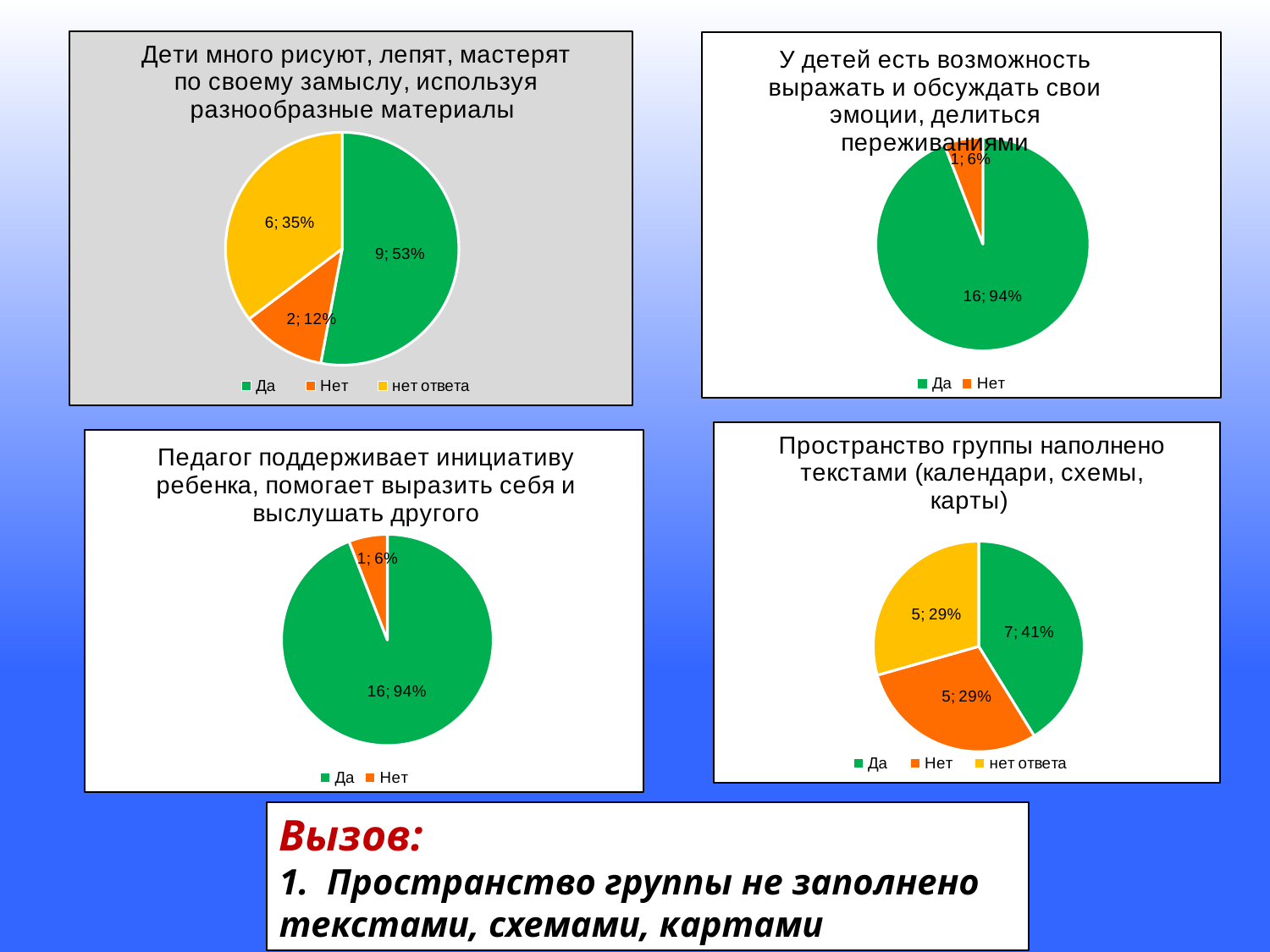
In the bottom-right chart, how many responses does the "Да" slice represent? 7 In the top-left chart, what share of the pie is the "Да" slice? 53% In the top-left chart, which category has the smallest slice? Нет In the bottom-right chart, what share of the pie is the "нет ответа" slice? 29% In the bottom-left chart, what share of the pie is the "Да" slice? 94% In the top-right chart, what is the difference in count between the "Да" and "Нет" slices? 15 What type of chart is used in the bottom-right chart? Pie chart In the top-left chart, how many responses does the "нет ответа" slice represent? 6 In the bottom-left chart, which category has the largest slice? Да In the top-right chart, how many responses does the "Да" slice represent? 16 In the top-left chart, how many categories does the legend list? 3